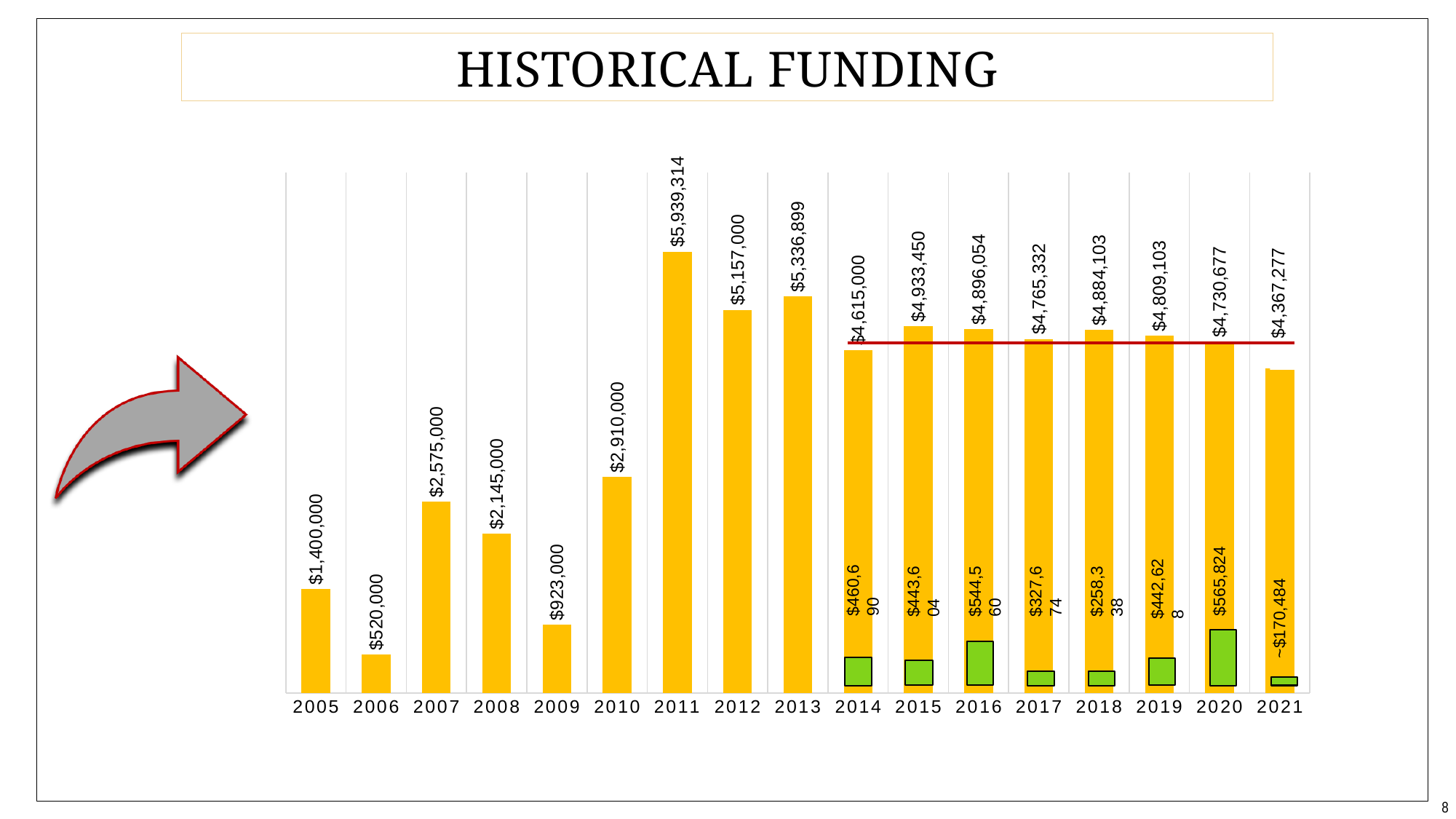
What is the funding value labelled for 2005? $1,400,000 What is the difference between the yellow bar values for 2007 and 2008? $430,000 What value is labelled on the small green bar for 2020? $565,824 Which year has the larger yellow funding bar, 2007 or 2010? 2010 How many years are shown on the x axis of the chart? 17 What kind of chart is shown on the slide? bar chart What is the difference between the yellow bar values for 2011 and 2012? $782,314 Do the yellow bar values rise or fall from 2018 to 2021? fall Which year has the highest yellow funding bar? 2011 What is the funding value labelled on the yellow bar for 2011? $5,939,314 What is the funding value labelled for 2021 on the yellow bar? $4,367,277 Which year has the lowest yellow funding bar? 2006